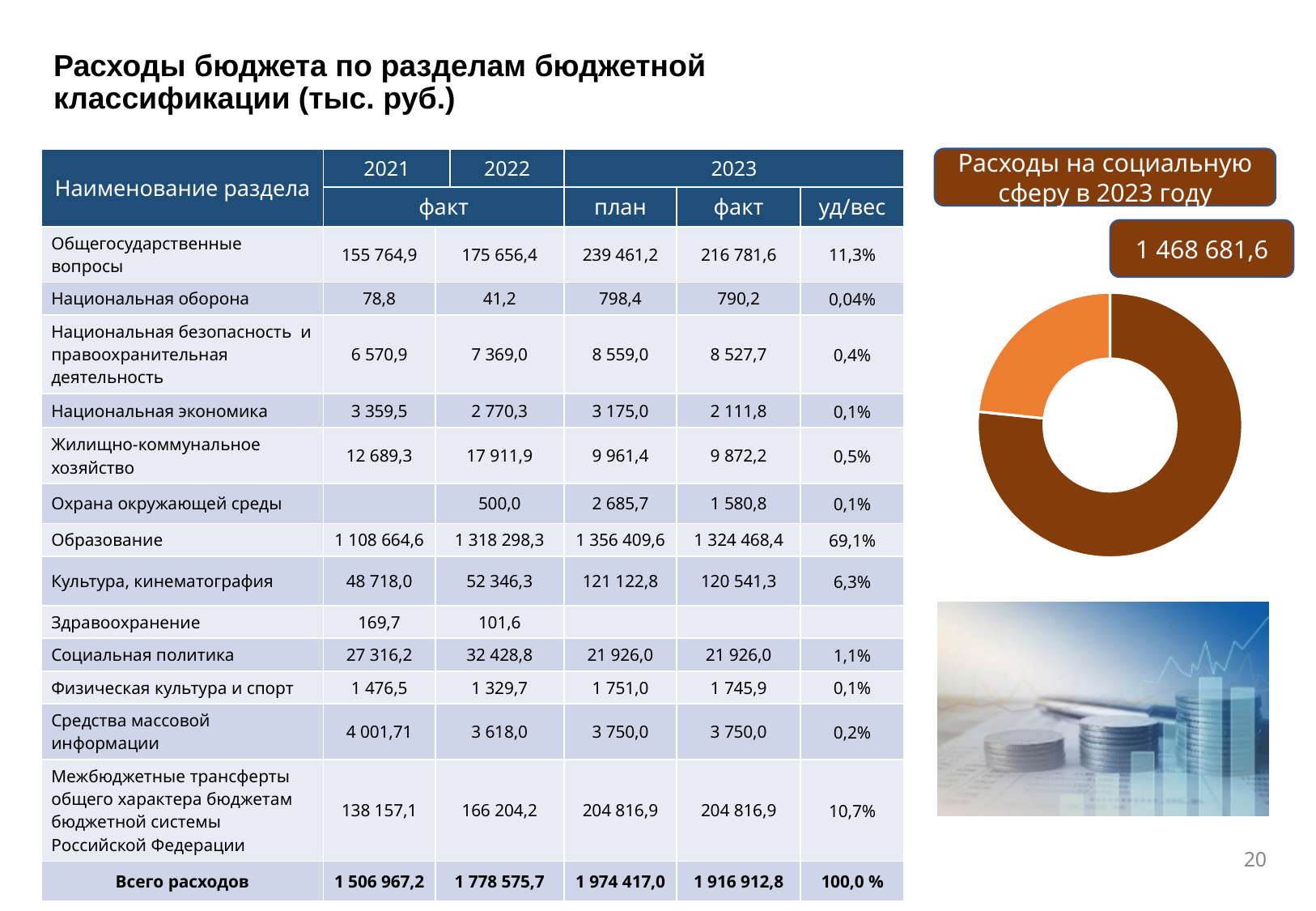
In the pie chart on the right of the slide, is the brown slice greater or less than half of the whole? greater How many slices does the pie chart on the right of the slide have? 2 What value is shown in the box above the pie chart on the right of the slide? 1 468 681,6 What kind of chart is shown on the right side of the slide? doughnut chart What is the title shown above the pie chart on the right of the slide? Расходы на социальную сферу в 2023 году In the pie chart on the right of the slide, which slice is larger, the brown one or the orange one? the brown one